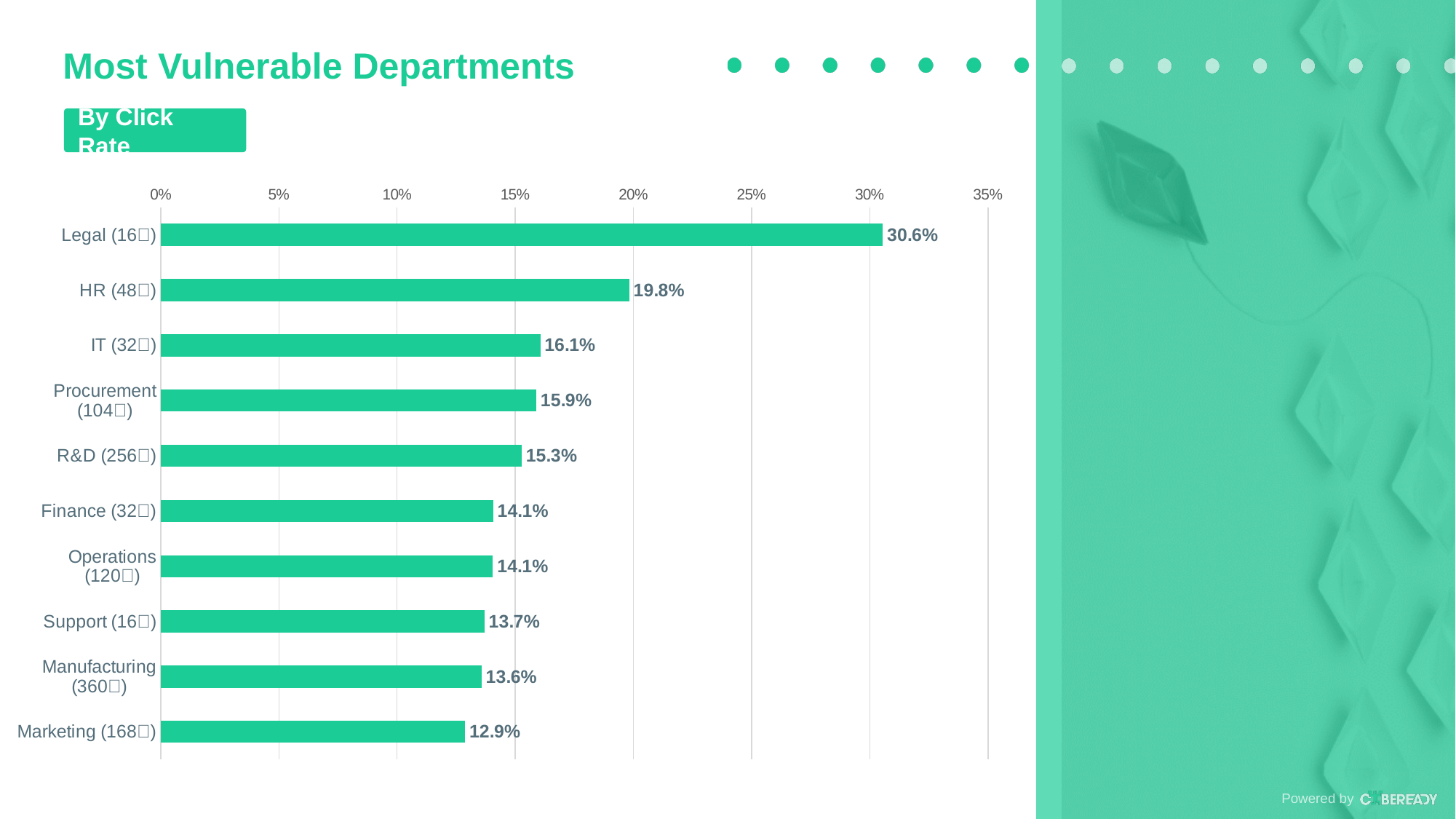
What is the title of the slide? Most Vulnerable Departments Do the click rates increase or decrease going from the top bar to the bottom bar? Decrease What is the difference in click rate between Legal and HR? 10.8% What is the click rate for HR? 19.8% Which has a higher click rate, HR or IT? HR What is the click rate for Manufacturing? 13.6% What is the click rate for the Legal department? 30.6% Is the click rate for Legal greater or less than 30%? greater How many departments are shown in the chart? 10 What kind of chart is shown on the slide? Bar chart Which department has the lowest click rate? Marketing Which department has the highest click rate? Legal